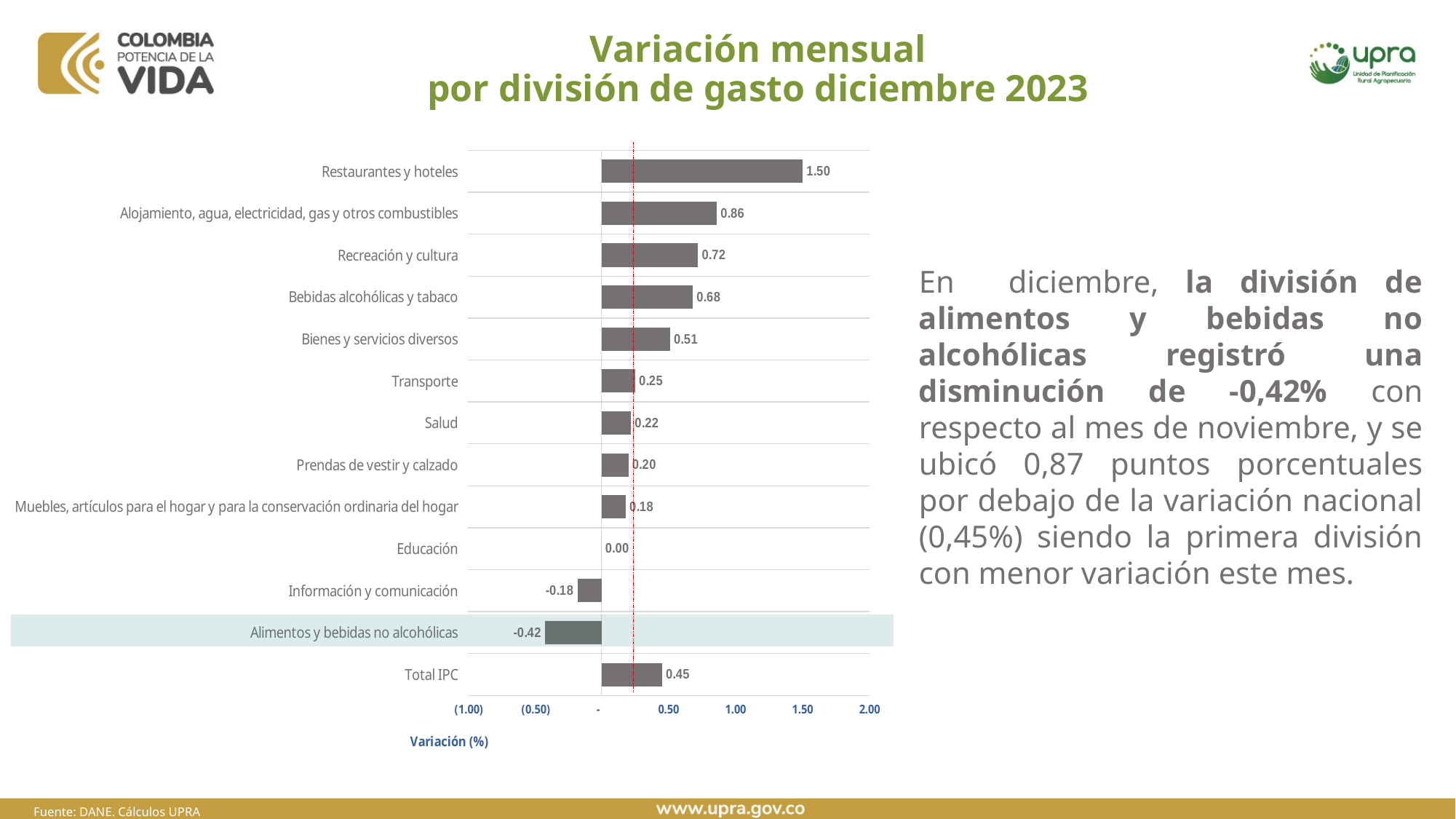
How many bars (categories) are shown in the chart? 13 What is the value for Alimentos y bebidas no alcohólicas? -0.42 What is the value for Total IPC? 0.45 Which is larger, the value for Salud or the value for Prendas de vestir y calzado? Salud What kind of chart is shown on the slide? Bar chart What is the difference between the values for Restaurantes y hoteles and Alojamiento, agua, electricidad, gas y otros combustibles? 0.64 Is the value for Restaurantes y hoteles greater or less than 1.00? greater What is the value for Transporte? 0.25 What is the value for Restaurantes y hoteles? 1.50 What is the difference between the values for Total IPC and Alimentos y bebidas no alcohólicas? 0.87 Which category has the highest value? Restaurantes y hoteles Which category has the lowest value? Alimentos y bebidas no alcohólicas